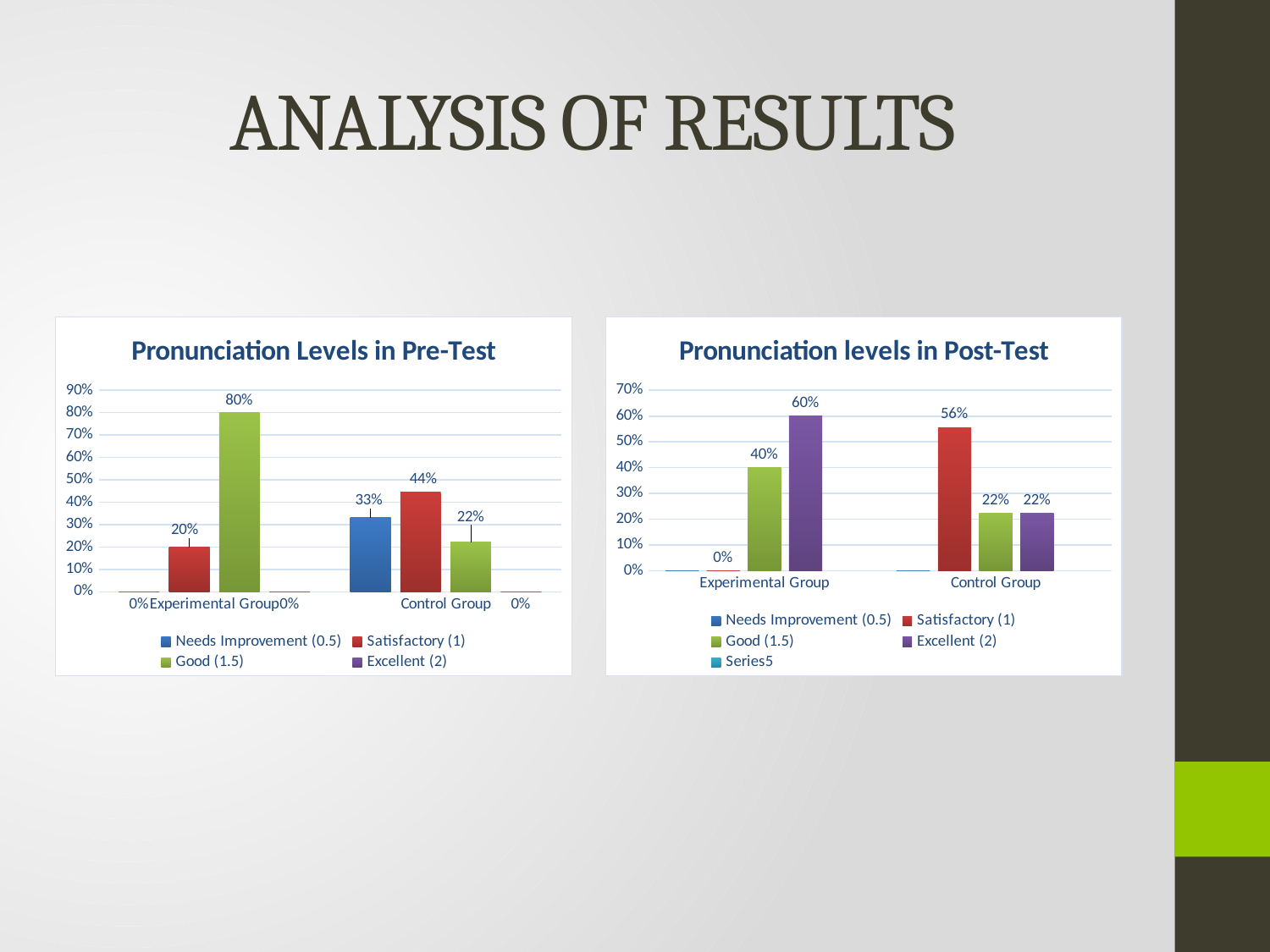
In the Pronunciation levels in Post-Test chart, how many series does the legend list? 5 In the Pronunciation Levels in Pre-Test chart, what is the value for Satisfactory (1) in the Control Group? 44% In the Pronunciation Levels in Pre-Test chart, what is the difference between the Good (1.5) values for the Experimental Group and the Control Group? 58 percentage points In the Pronunciation levels in Post-Test chart, what is the value for Satisfactory (1) in the Control Group? 56% In the Pronunciation Levels in Pre-Test chart, what is the value for Good (1.5) in the Experimental Group? 80% In the Pronunciation levels in Post-Test chart, which series has the highest value for the Control Group? Satisfactory (1) In the Pronunciation Levels in Pre-Test chart, how many groups are shown on the x axis? 2 What kind of chart is the Pronunciation Levels in Pre-Test chart? Bar chart In the Pronunciation Levels in Pre-Test chart, which series has the highest value for the Experimental Group? Good (1.5) In the Pronunciation levels in Post-Test chart, which group has the larger Good (1.5) value, the Experimental Group or the Control Group? Experimental Group In the Pronunciation Levels in Pre-Test chart, what is the value for Needs Improvement (0.5) in the Control Group? 33% In the Pronunciation levels in Post-Test chart, what is the value for Excellent (2) in the Experimental Group? 60%